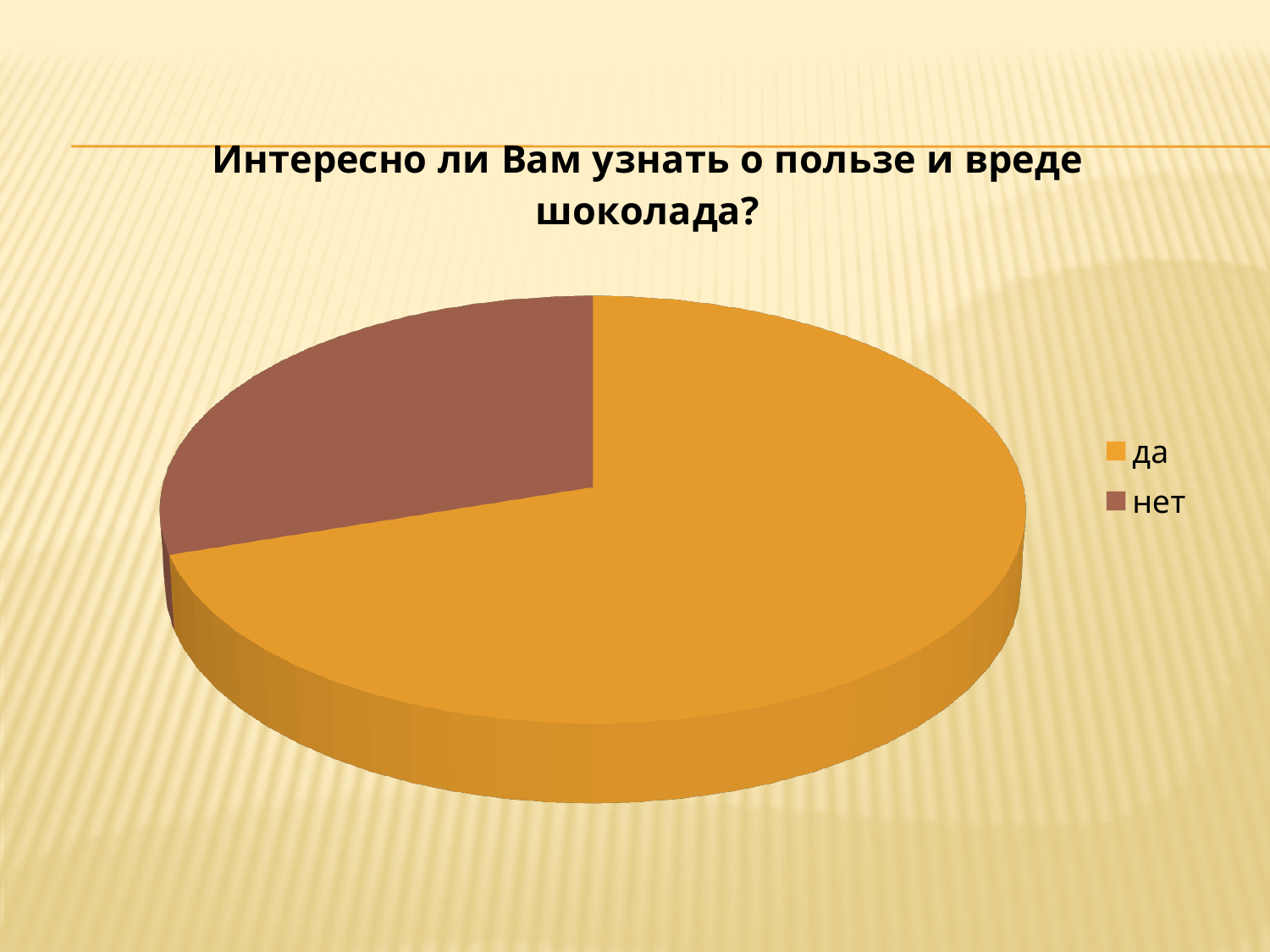
Which category has the largest slice of the pie? да How many slices does the pie chart have? 2 What kind of chart is shown on the slide? pie chart What colour is the slice for "нет"? brown Which slice is larger, "да" or "нет"? да Which category has the smallest slice of the pie? нет How many entries does the legend list? 2 What is the title of the chart? Интересно ли Вам узнать о пользе и вреде шоколада?